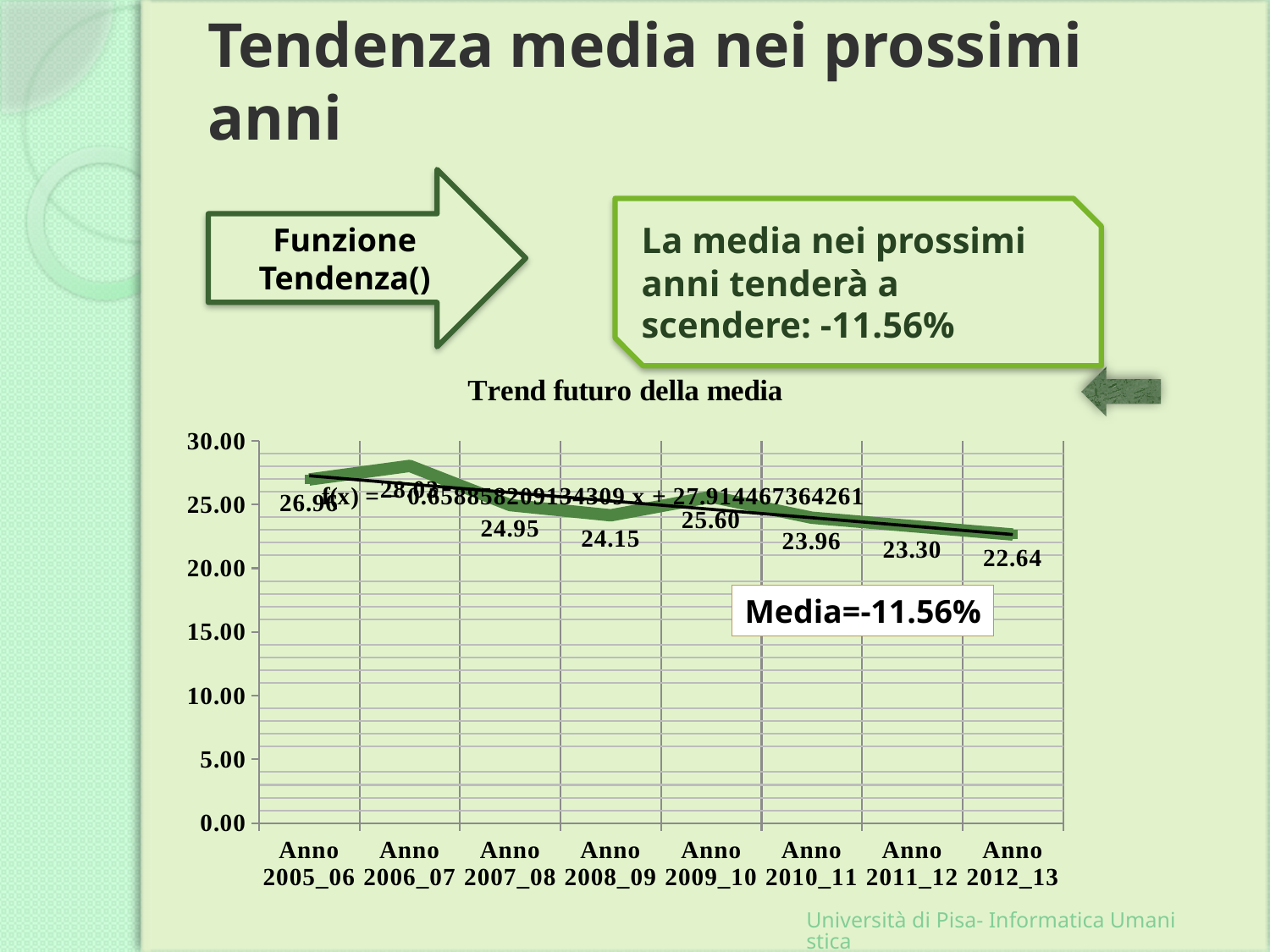
Which is larger, the value for Anno 2008_09 or Anno 2009_10? Anno 2009_10 How many years are plotted on the x axis? 8 Do the values generally rise or fall from Anno 2005_06 to Anno 2012_13? fall Which year has the highest value? Anno 2006_07 What is the title of the chart? Trend futuro della media What is the value for Anno 2009_10? 25.60 What is the difference between the values for Anno 2005_06 and Anno 2012_13? 4.32 Which year has the lowest value? Anno 2012_13 What is the value for Anno 2005_06? 26.96 What is the value for Anno 2007_08? 24.95 What is the value for Anno 2012_13? 22.64 What kind of chart is shown on the slide? line chart